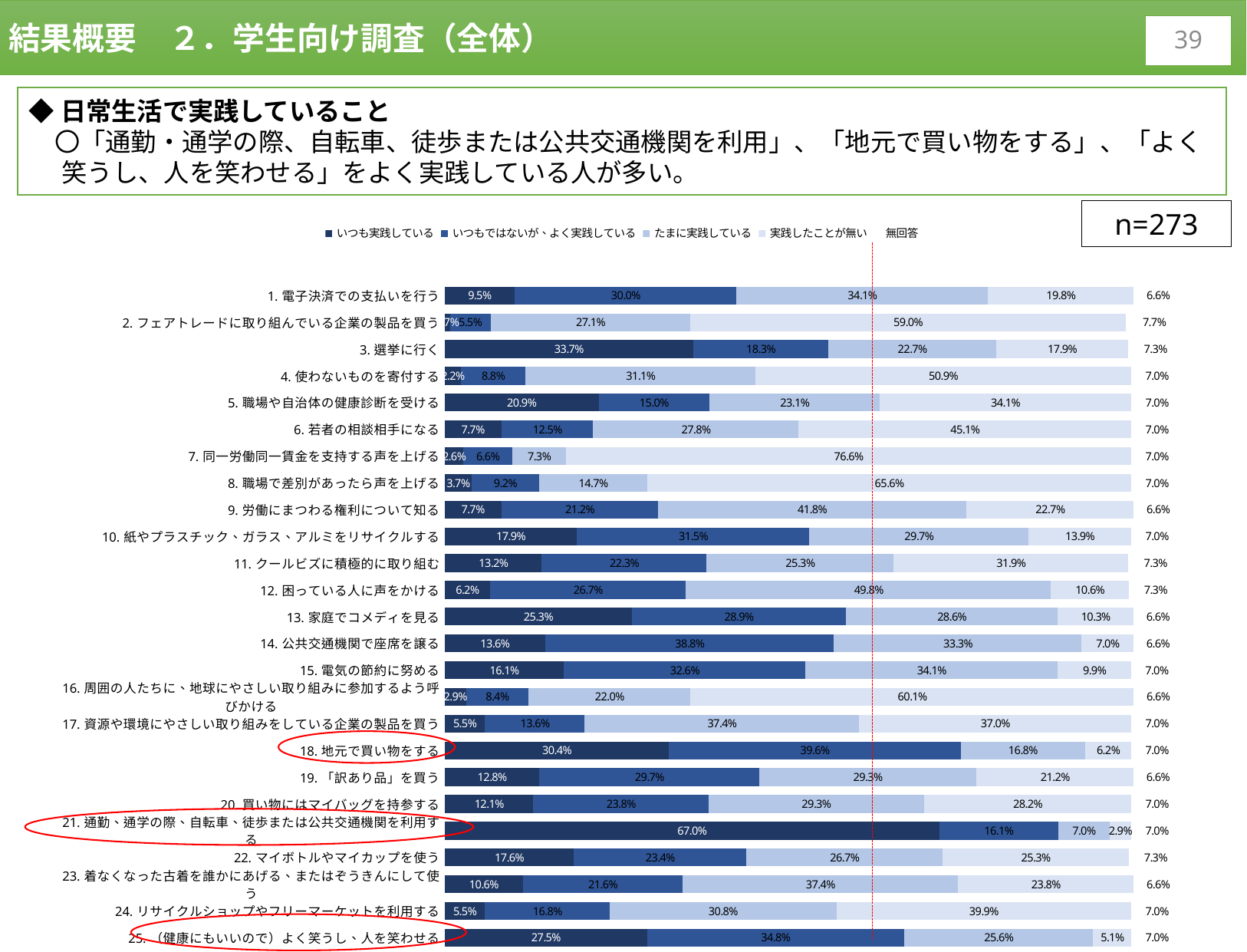
What is the 「無回答」 value for item 2 (フェアトレードに取り組んでいる企業の製品を買う)? 7.7% What kind of chart is shown on the slide? Stacked horizontal bar chart Which item has the highest 「実践したことが無い」 percentage? 7. 同一労働同一賃金を支持する声を上げる What is the 「いつもではないが、よく実践している」 value for item 14 (公共交通機関で座席を譲る)? 38.8% What percentage of respondents answered 「いつも実践している」 for item 21 (通勤、通学の際、自転車、徒歩または公共交通機関を利用する)? 67.0% How many response categories does the legend list? 5 How many items (categories) are shown in the chart? 25 Which has a larger 「いつも実践している」 share: item 3 (選挙に行く) or item 13 (家庭でコメディを見る)? 3. 選挙に行く What is the 「実践したことが無い」 value for item 7 (同一労働同一賃金を支持する声を上げる)? 76.6% What is the difference in 「いつも実践している」 between item 18 (地元で買い物をする) and item 25 (よく笑うし、人を笑わせる)? 2.9 percentage points What is the sample size (n) shown on the slide? n=273 Which item has the highest 「いつも実践している」 percentage? 21. 通勤、通学の際、自転車、徒歩または公共交通機関を利用する